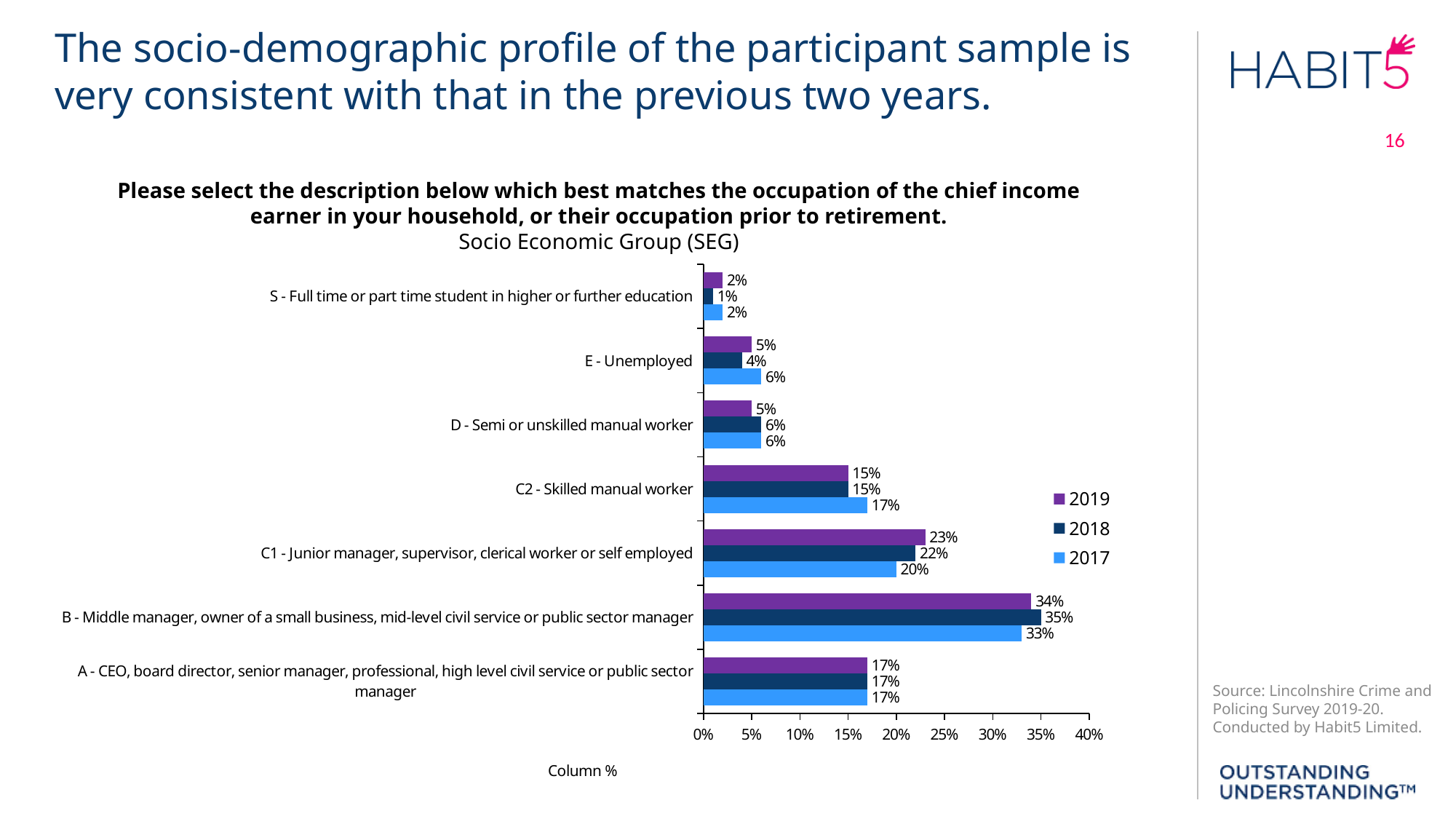
What is the 2018 value for S - Full time or part time student in higher or further education? 1% Which year is shown in purple in the legend? 2019 How many series does the legend list? 3 What is the difference between the 2019 and 2017 values for C1 - Junior manager, supervisor, clerical worker or self employed? 3% For E - Unemployed, which year has the larger value, 2017 or 2018? 2017 What is the 2017 value for C1 - Junior manager, supervisor, clerical worker or self employed? 20% How many socio economic groups are shown on the chart? 7 Is the 2018 value for B - Middle manager, owner of a small business, mid-level civil service or public sector manager greater or less than 30%? greater Which socio economic group has the lowest value in 2019? S - Full time or part time student in higher or further education What kind of chart is shown on the slide? Bar chart Which socio economic group has the highest value in 2018? B - Middle manager, owner of a small business, mid-level civil service or public sector manager What percentage of the 2019 sample falls in group B - Middle manager, owner of a small business, mid-level civil service or public sector manager? 34%